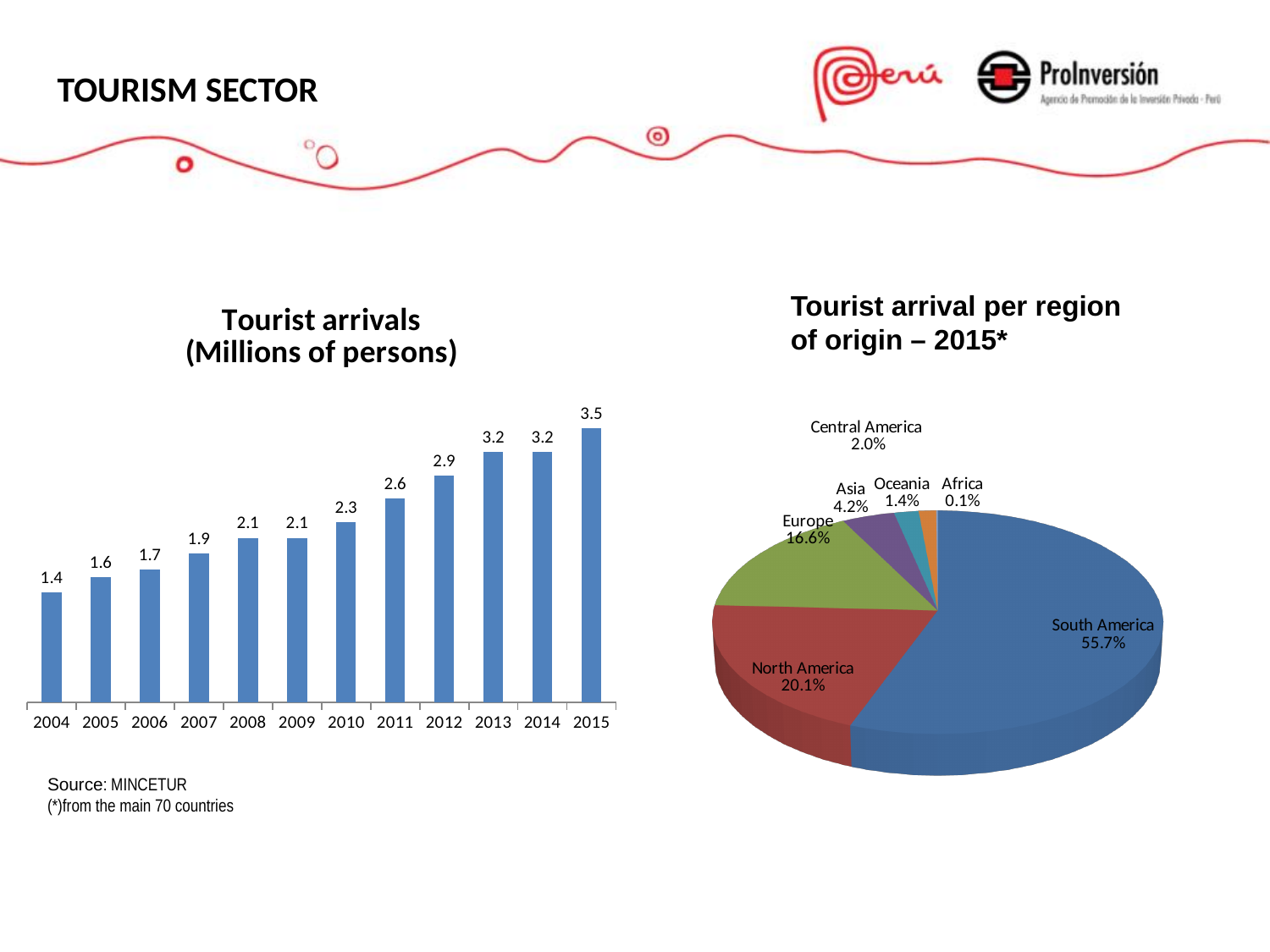
In the 'Tourist arrivals (Millions of persons)' chart, do the values generally rise or fall from 2004 to 2015? Rise In the 'Tourist arrivals (Millions of persons)' chart, which year has the lowest value? 2004 In the 'Tourist arrival per region of origin – 2015*' chart, which is larger, North America or Europe? North America In the 'Tourist arrivals (Millions of persons)' chart, how many years are shown on the x axis? 12 In the 'Tourist arrival per region of origin – 2015*' chart, which region has the smallest share? Africa In the 'Tourist arrivals (Millions of persons)' chart, which year has the highest value? 2015 In the 'Tourist arrivals (Millions of persons)' chart, what is the difference between the values for 2015 and 2004? 2.1 In the 'Tourist arrivals (Millions of persons)' chart, what is the value for 2015? 3.5 In the 'Tourist arrivals (Millions of persons)' chart, what is the value for 2004? 1.4 What kind of chart is the 'Tourist arrivals (Millions of persons)' chart? Bar chart What kind of chart is the 'Tourist arrival per region of origin – 2015*' chart? Pie chart In the 'Tourist arrival per region of origin – 2015*' chart, what share does South America have? 55.7%